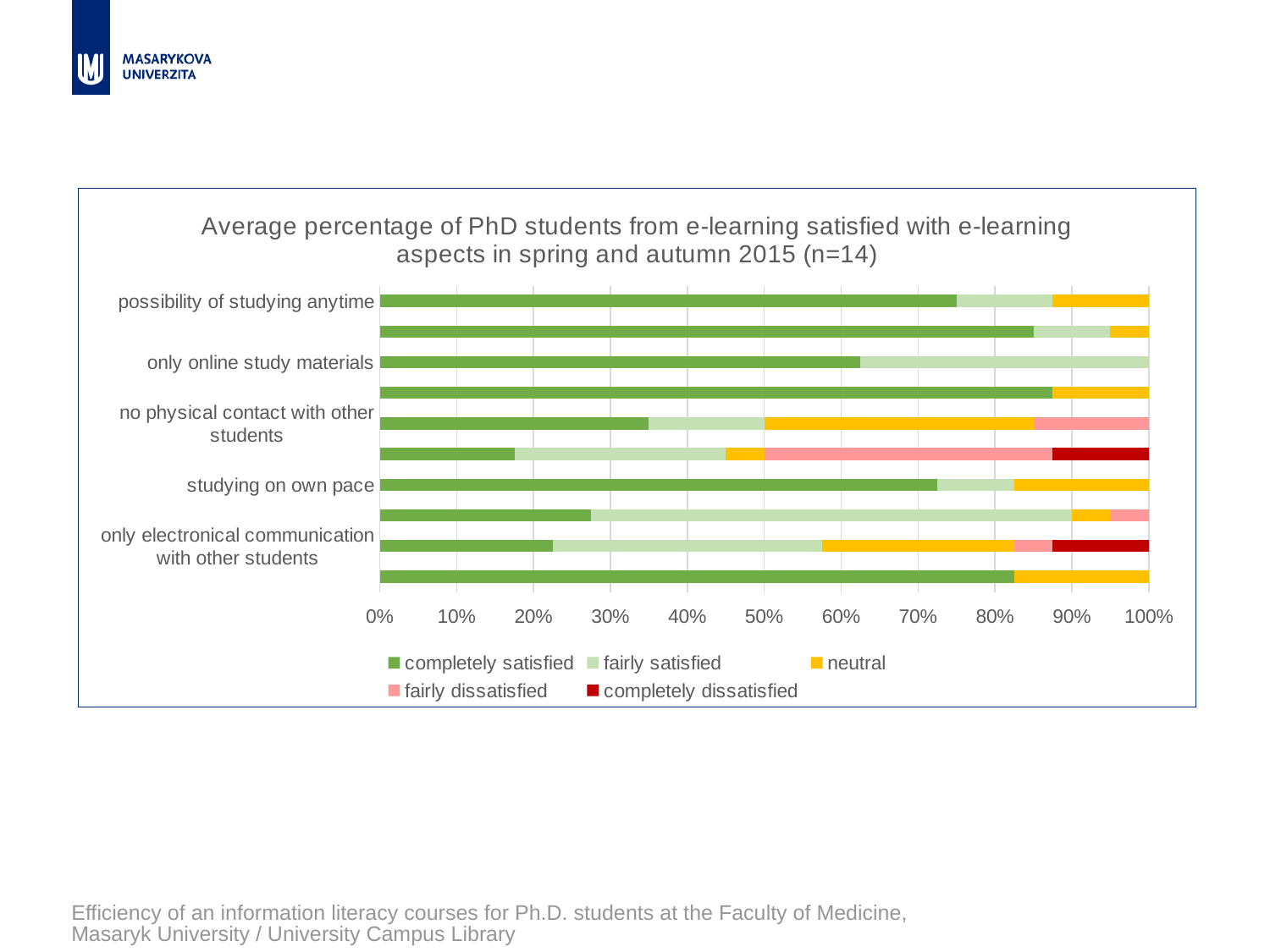
For 'no physical contact with other students', which segment is larger: 'completely satisfied' or 'fairly satisfied'? completely satisfied How many category labels are shown on the vertical axis of the chart? 5 Is the 'completely satisfied' share for 'only online study materials' greater or less than 50%? greater What kind of chart is shown on the slide? stacked bar chart Which legend entry is shown in dark red? completely dissatisfied How many series does the legend list? 5 What is the highest value shown on the horizontal axis? 100% Is the 'completely satisfied' share for 'no physical contact with other students' greater or less than 40%? less For 'only electronical communication with other students', which segment is larger: 'completely satisfied' or 'fairly satisfied'? fairly satisfied Is the 'completely satisfied' share for 'possibility of studying anytime' greater or less than 70%? greater